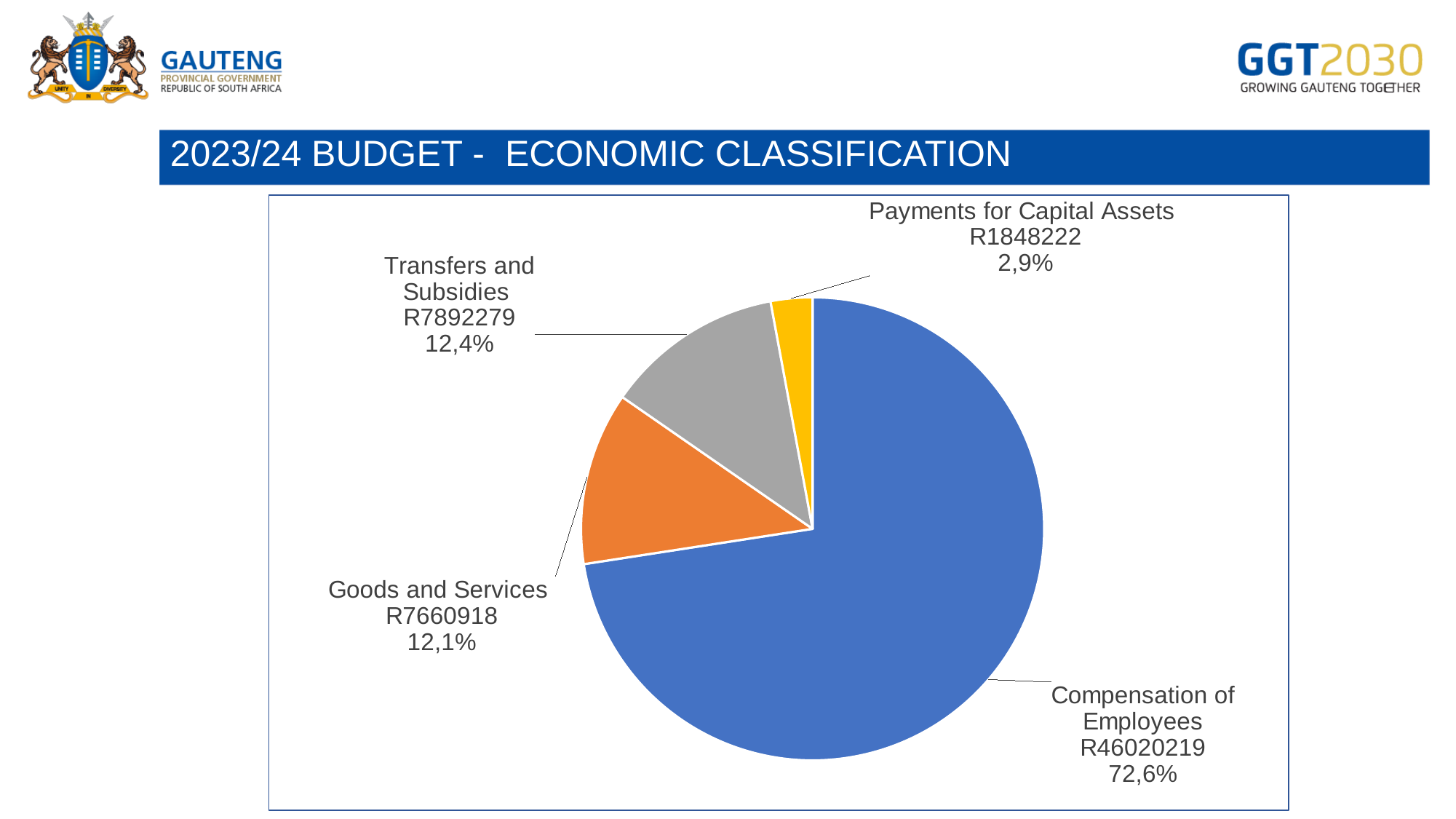
What type of chart is shown on the slide? pie chart What share of the pie does Compensation of Employees represent? 72,6% What is the value for Compensation of Employees? R46020219 What is the title of the slide containing the chart? 2023/24 BUDGET - ECONOMIC CLASSIFICATION What share of the pie does Payments for Capital Assets represent? 2,9% What is the value for Payments for Capital Assets? R1848222 What is the difference between the values for Transfers and Subsidies and Goods and Services? R231361 Which category has the largest slice? Compensation of Employees What is the value for Goods and Services? R7660918 How many categories does the pie chart show? 4 What is the value for Transfers and Subsidies? R7892279 Which category has the smallest slice? Payments for Capital Assets